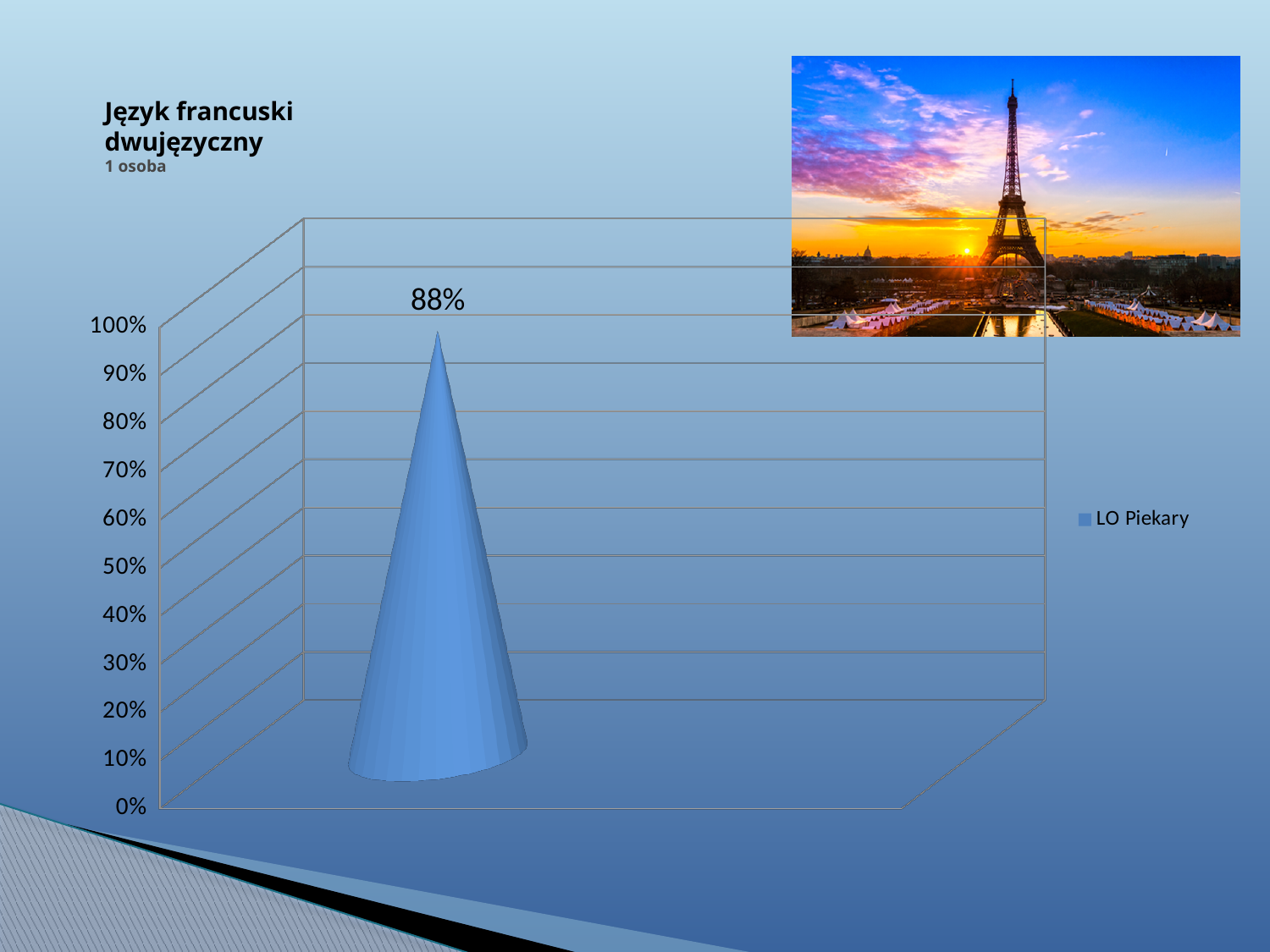
Is the value for LO Piekary greater or less than 90%? less What value is shown for LO Piekary on the chart? 88% What is the title of the chart on the slide? Język francuski dwujęzyczny How many data points are plotted on the chart? 1 What is the name of the series listed in the legend? LO Piekary What kind of chart is shown on the slide? bar chart Is the value for LO Piekary greater or less than 80%? greater Is the value for LO Piekary greater or less than 50%? greater How many series does the legend list? 1